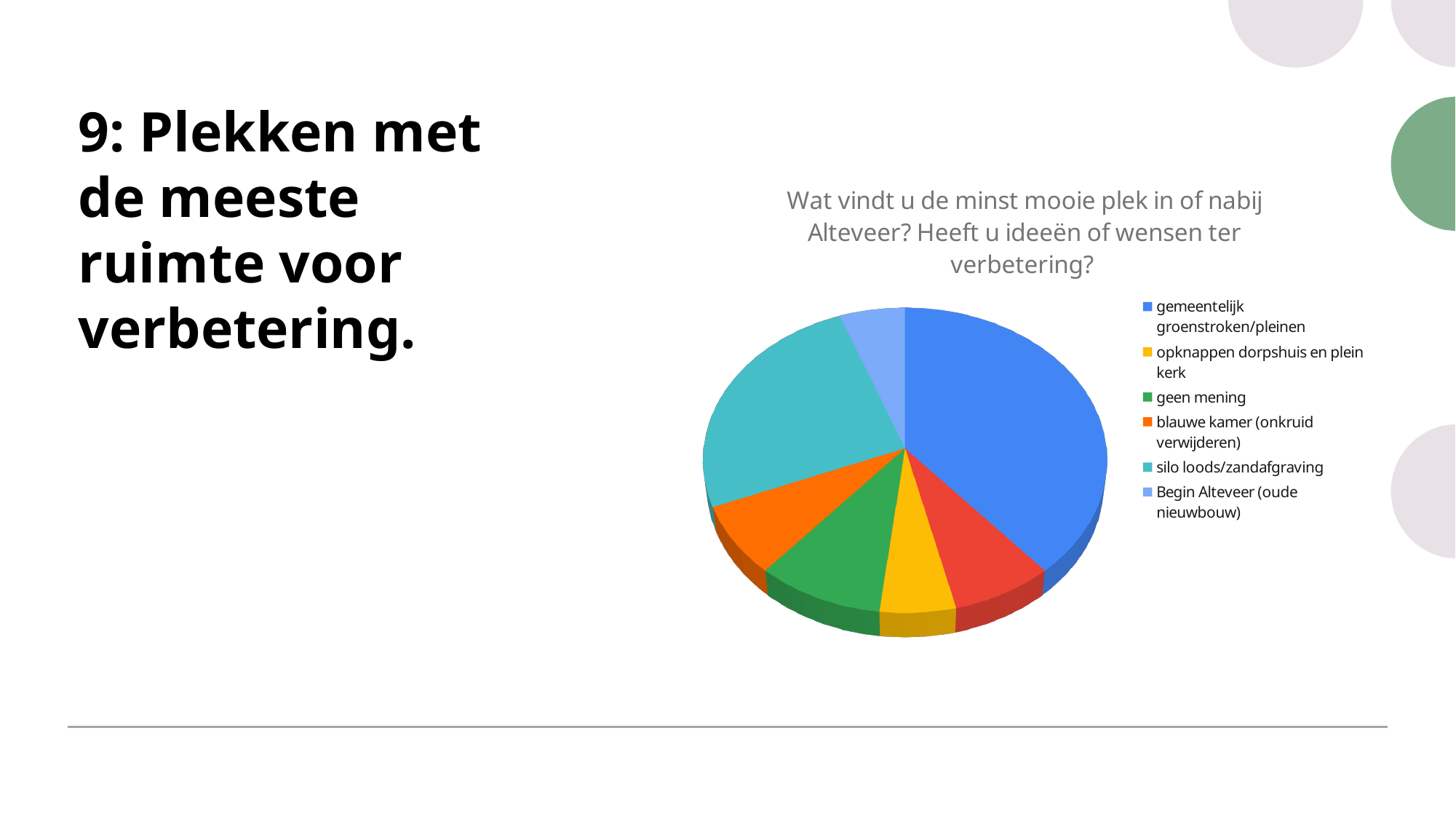
Which slice is larger: gemeentelijk groenstroken/pleinen or opknappen dorpshuis en plein kerk? gemeentelijk groenstroken/pleinen How many entries does the legend of the pie chart list? 6 What kind of chart is shown on the slide? pie chart Which slice is larger: gemeentelijk groenstroken/pleinen or silo loods/zandafgraving? gemeentelijk groenstroken/pleinen Which slice is larger: silo loods/zandafgraving or Begin Alteveer (oude nieuwbouw)? silo loods/zandafgraving What is the title of the pie chart? Wat vindt u de minst mooie plek in of nabij Alteveer? Heeft u ideeën of wensen ter verbetering? Which colour represents 'geen mening' in the pie chart? green Which category has the largest slice in the pie chart? gemeentelijk groenstroken/pleinen